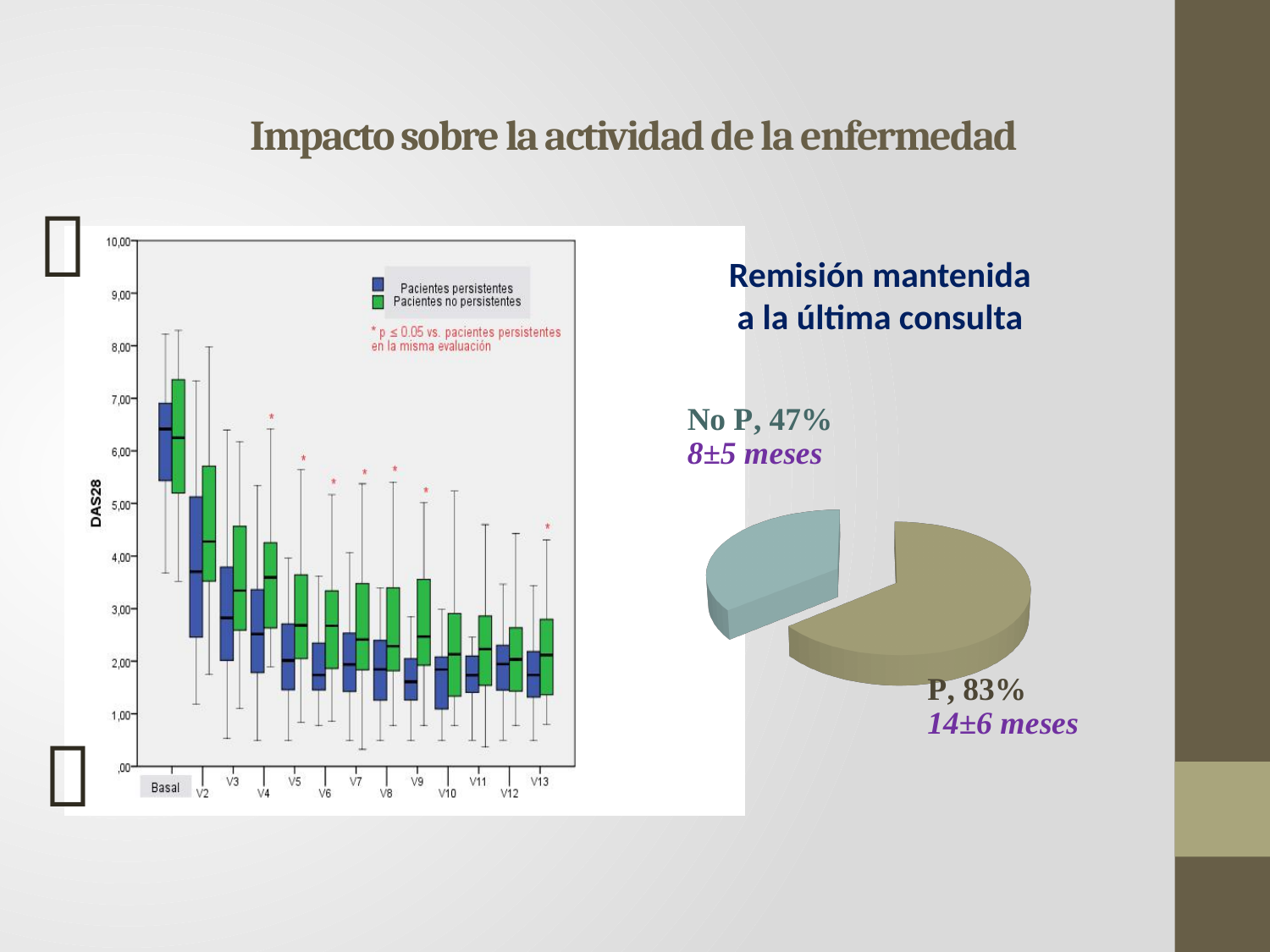
In the pie chart 'Remisión mantenida a la última consulta', what duration in months is given next to the P slice? 14±6 meses In the pie chart 'Remisión mantenida a la última consulta', how many slices are there? 2 What kind of chart is the chart on the right of the slide, titled 'Remisión mantenida a la última consulta'? pie chart In the pie chart 'Remisión mantenida a la última consulta', which slice is larger, P or No P? P In the DAS28 chart on the left, is the median for Pacientes persistentes at Basal greater or less than 5,00? greater In the pie chart 'Remisión mantenida a la última consulta', what percentage is shown for P? 83% In the DAS28 chart on the left, do the DAS28 values generally rise or fall from Basal to V13? fall In the DAS28 chart on the left, how many visit categories are shown on the x axis (from Basal to V13)? 13 In the DAS28 chart on the left, which series is shown in green? Pacientes no persistentes In the pie chart 'Remisión mantenida a la última consulta', what percentage is shown for No P? 47% In the pie chart 'Remisión mantenida a la última consulta', what duration in months is given next to the No P slice? 8±5 meses In the DAS28 chart on the left, how many series does the legend list? 2